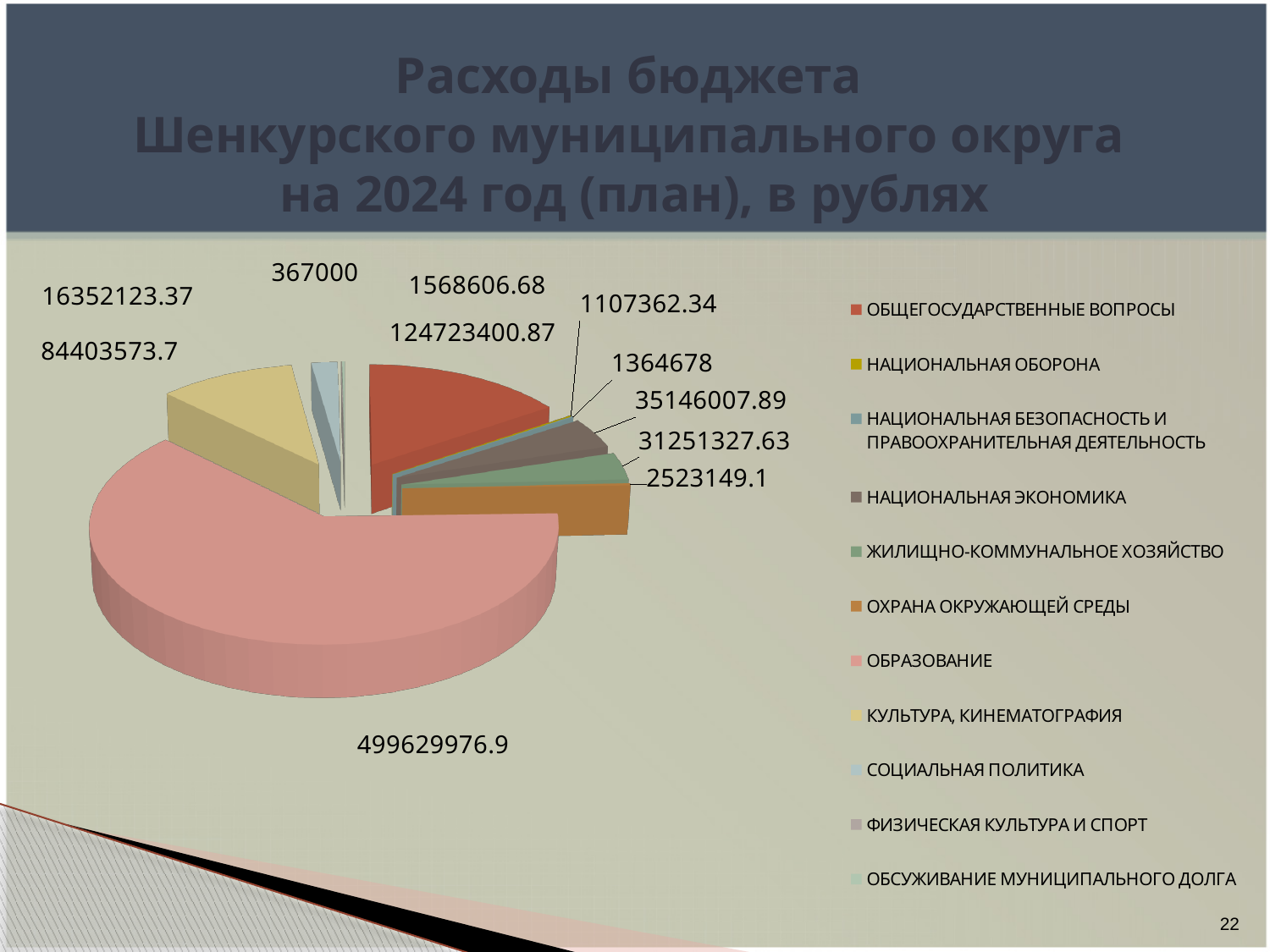
Which category has the largest slice of the pie chart? ОБРАЗОВАНИЕ How many categories does the legend of the pie chart list? 11 Which is larger: ОБРАЗОВАНИЕ or ОБЩЕГОСУДАРСТВЕННЫЕ ВОПРОСЫ? ОБРАЗОВАНИЕ What colour is the slice for ОБРАЗОВАНИЕ in the pie chart? pink What is the difference between the values for ОБРАЗОВАНИЕ and ОБЩЕГОСУДАРСТВЕННЫЕ ВОПРОСЫ? 374906576.03 What is the value shown for ОБЩЕГОСУДАРСТВЕННЫЕ ВОПРОСЫ? 124723400.87 What is the value shown for НАЦИОНАЛЬНАЯ ЭКОНОМИКА? 35146007.89 What is the smallest value labelled on the pie chart? 367000 What is the value shown for КУЛЬТУРА, КИНЕМАТОГРАФИЯ? 84403573.7 What is the value shown for ОБРАЗОВАНИЕ? 499629976.9 What kind of chart is shown on the slide? pie chart What year does the chart title say the budget expenditure plan is for? 2024